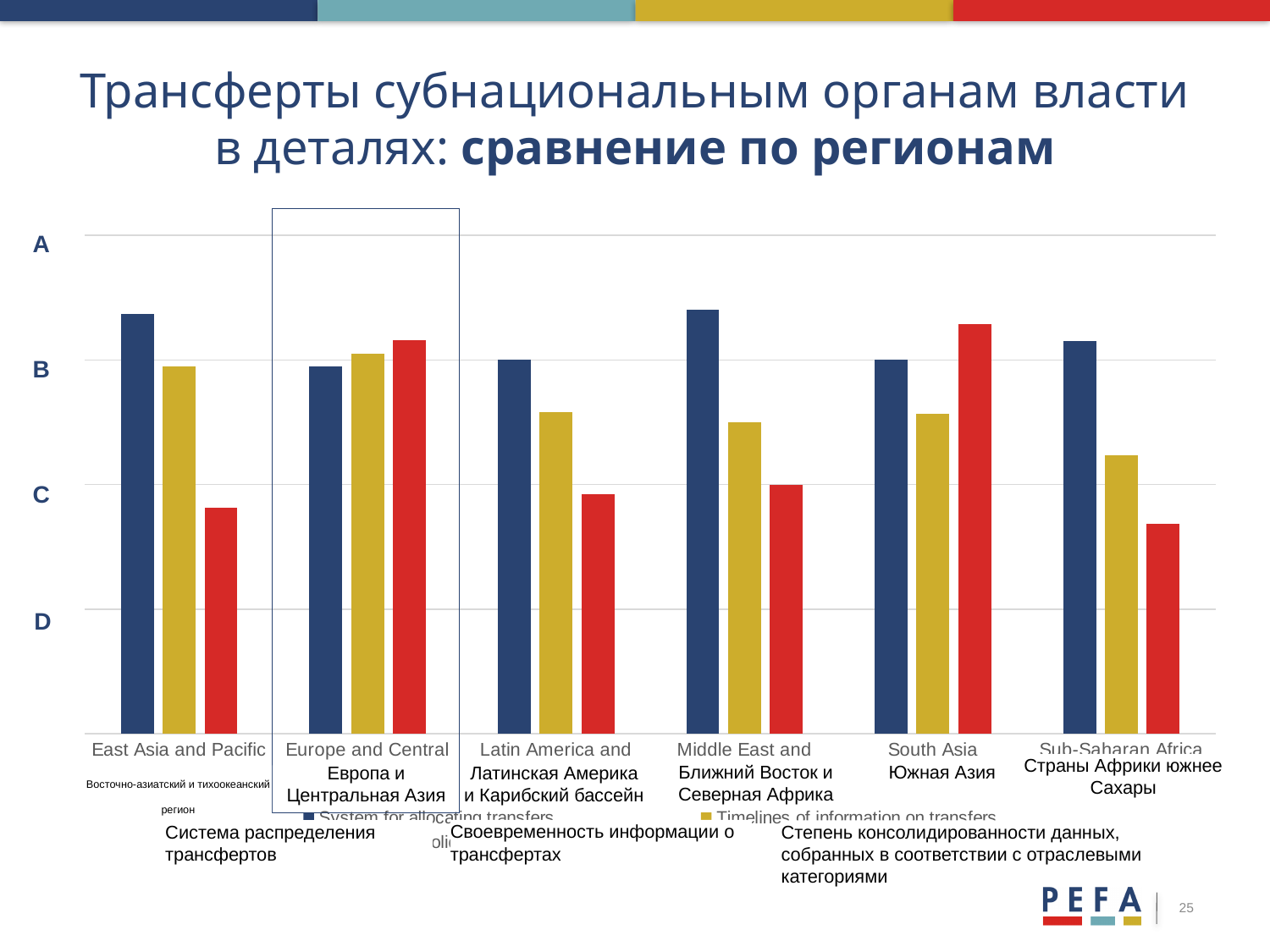
Is the red bar for South Asia above or below the B gridline? above Which region has the lowest yellow bar (timeliness of information on transfers)? Sub-Saharan Africa How many regions are shown along the x axis of the chart? 6 Is the red bar for East Asia and Pacific above or below the B gridline? below What kind of chart is shown on the slide? bar chart How many series does the chart's legend list? 3 What letter grades are shown on the y axis of the chart? A, B, C, D What colour are the bars for the series 'System for allocating transfers'? blue For South Asia, which is higher: the blue bar or the red bar? the red bar For Middle East and North Africa, which is higher: the blue bar or the red bar? the blue bar For Sub-Saharan Africa, which is higher: the yellow bar or the red bar? the yellow bar Which region has the highest red bar (degree of consolidation of data)? South Asia